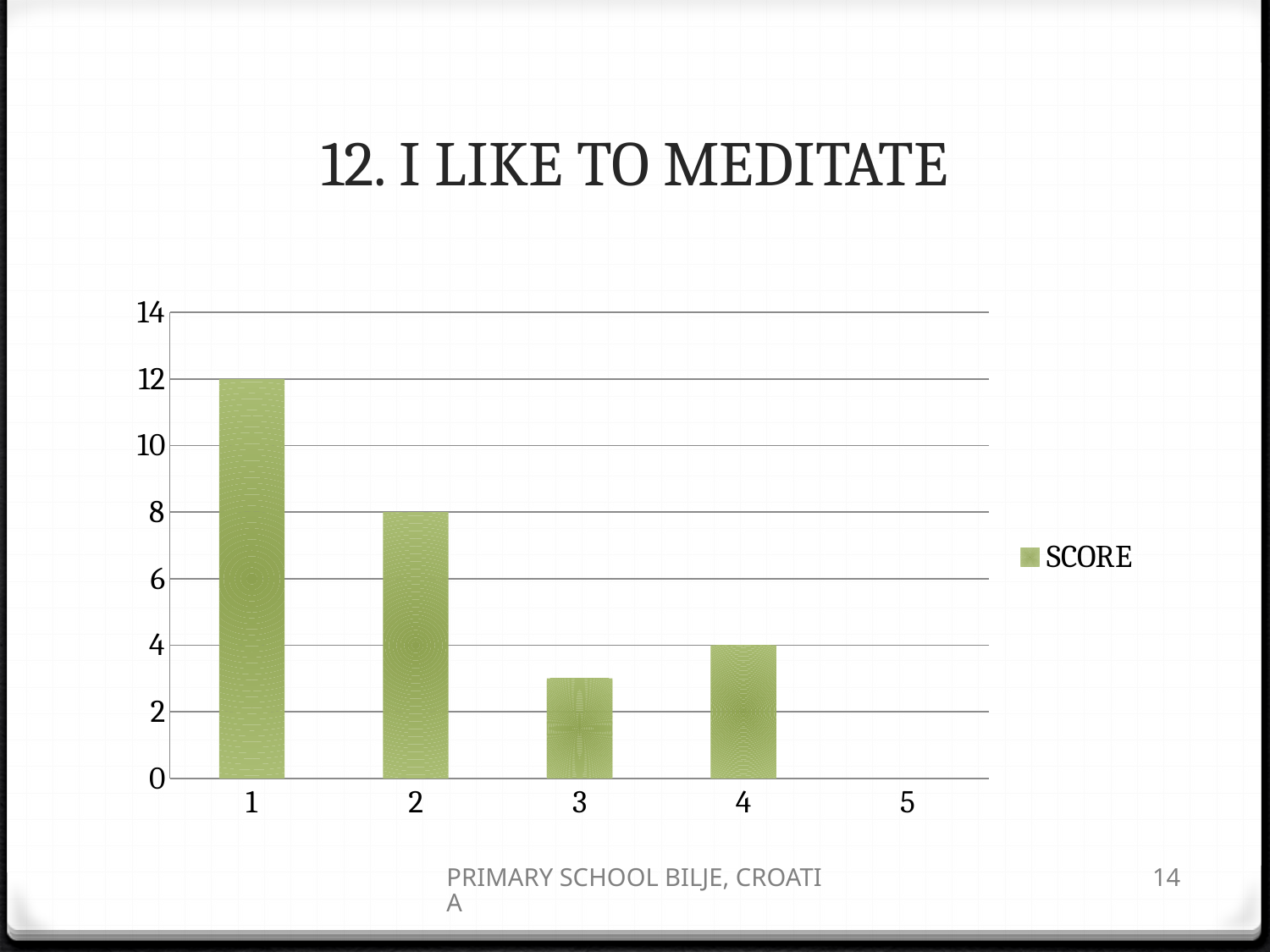
What is the SCORE value for category 1? 12 Which has a larger SCORE, category 2 or category 4? 2 What is the SCORE value for category 2? 8 How many series does the legend list? 1 Which category has the highest SCORE? 1 What type of chart is shown on the slide? bar chart Is the value for category 3 greater or less than 2? greater What is the difference between the SCORE for category 1 and category 4? 8 What is the SCORE value for category 4? 4 Is the value for category 3 greater or less than 4? less What is the difference between the SCORE for category 1 and category 2? 4 How many categories are shown on the x axis? 5